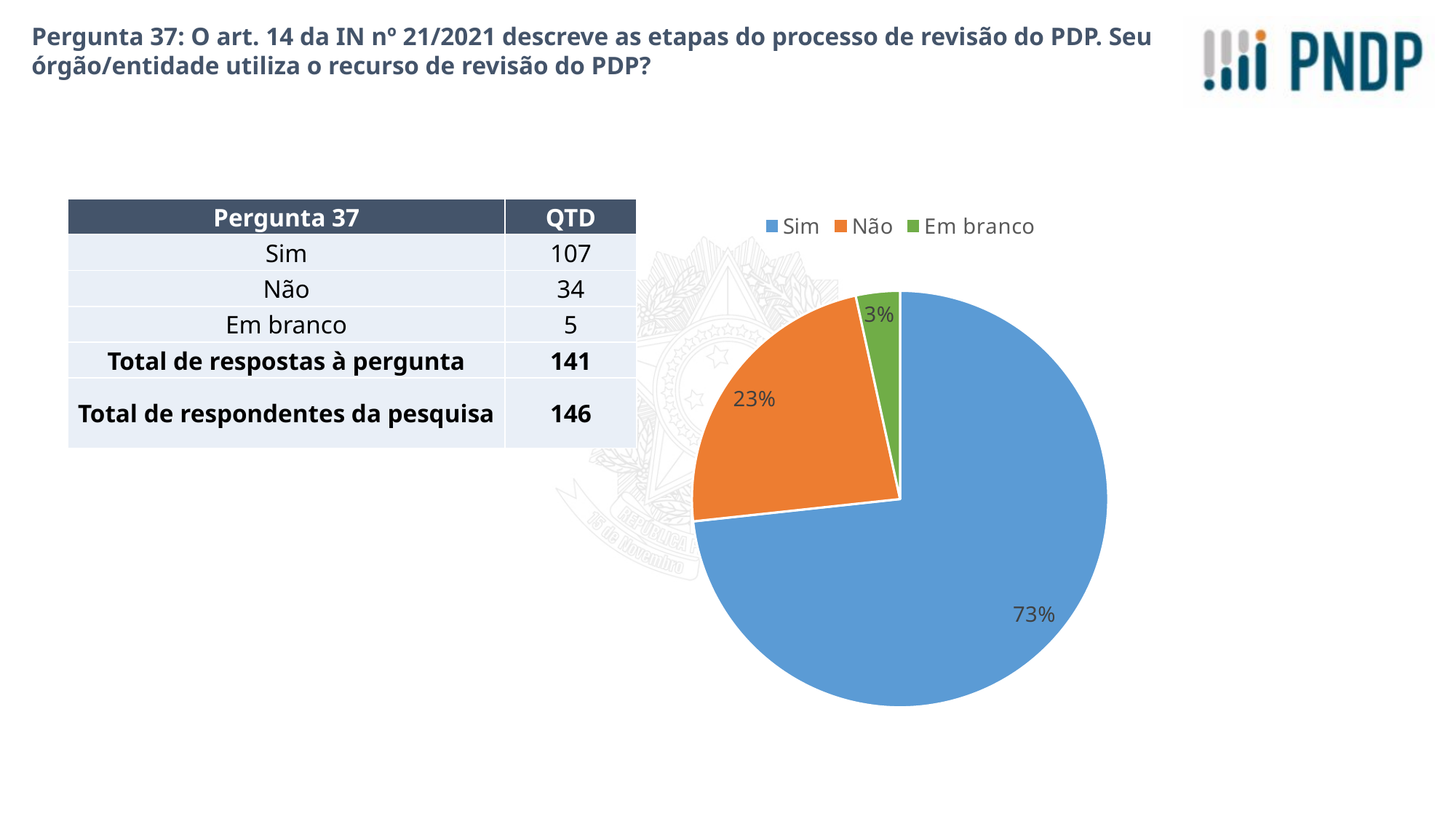
How many slices does the pie chart have? 3 What colour is the "Em branco" slice in the pie chart? green Which category has the largest slice of the pie? Sim How many entries does the legend list? 3 What kind of chart is shown on the slide? pie chart What share of the pie does the "Sim" slice represent? 73% Which category has the smallest slice of the pie? Em branco Which slice is larger, "Não" or "Em branco"? Não What share of the pie does the "Em branco" slice represent? 3% What is the difference in percentage points between the "Sim" slice and the "Não" slice? 50% What colour is the "Não" slice in the pie chart? orange What share of the pie does the "Não" slice represent? 23%